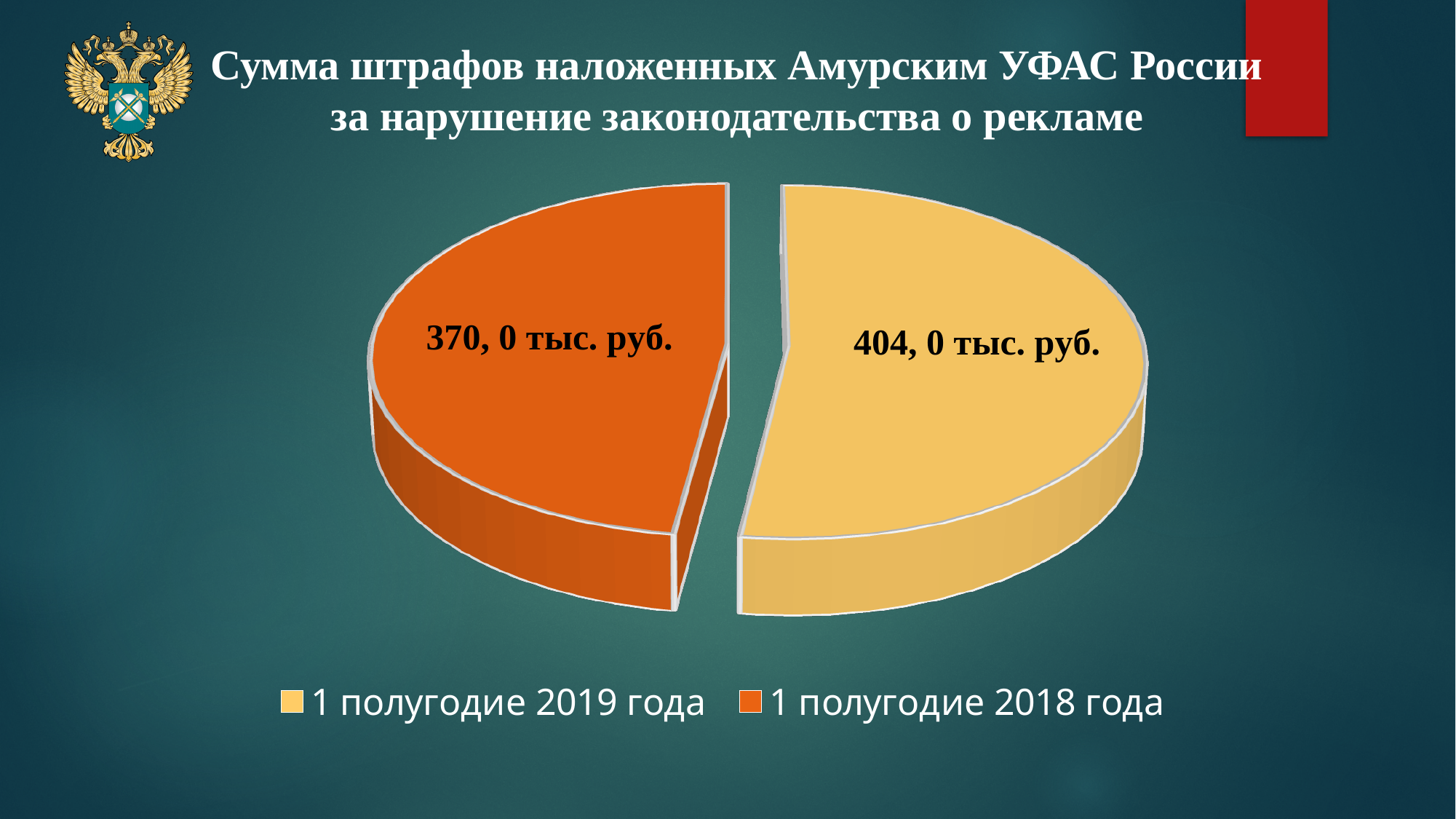
Which period has the smaller sum of fines? 1 полугодие 2018 года What kind of chart is shown on the slide? Pie chart Which period has the larger sum of fines? 1 полугодие 2019 года Which colour represents 1 полугодие 2018 года? Orange What is the value for 1 полугодие 2018 года? 370, 0 тыс. руб. How many entries does the legend list? 2 What is the value for 1 полугодие 2019 года? 404, 0 тыс. руб. What is the title of the chart? Сумма штрафов наложенных Амурским УФАС России за нарушение законодательства о рекламе What is the difference between the values for 1 полугодие 2019 года and 1 полугодие 2018 года? 34, 0 тыс. руб. What is the total of the two slices? 774, 0 тыс. руб. Is the value for 1 полугодие 2019 года larger or smaller than the value for 1 полугодие 2018 года? Larger How many slices does the pie chart have? 2